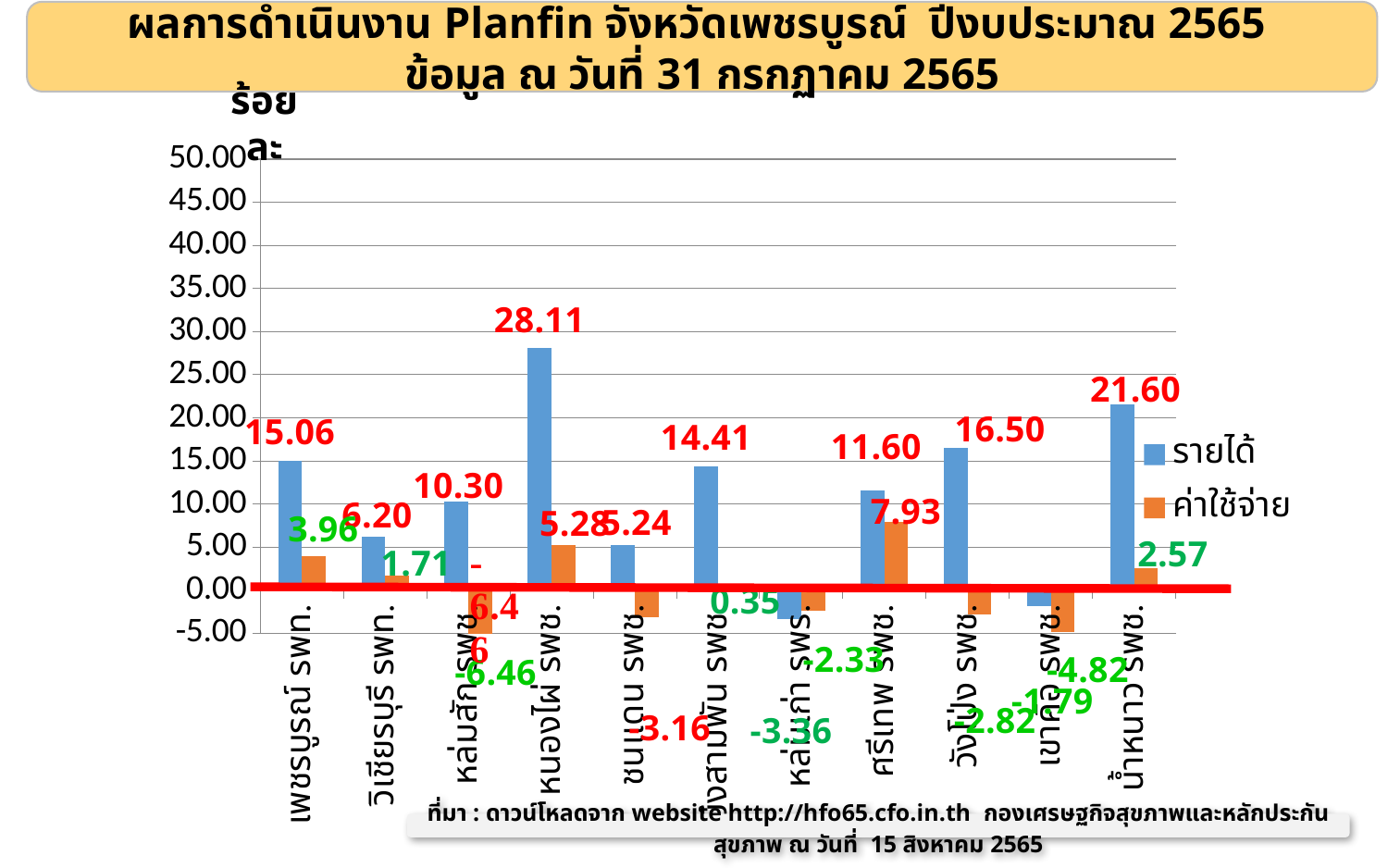
Which hospital has the highest ค่าใช้จ่าย value? ศรีเทพ รพช. What is the รายได้ value for น้ำหนาว รพช.? 21.60 What is the difference between the รายได้ and ค่าใช้จ่าย values for เพชรบูรณ์ รพท.? 11.10 What is the ค่าใช้จ่าย value for เพชรบูรณ์ รพท.? 3.96 Which has the larger รายได้ value, วังโป่ง รพช. or เพชรบูรณ์ รพท.? วังโป่ง รพช. What are the two series named in the legend? รายได้ and ค่าใช้จ่าย How many hospitals (categories) are shown on the x axis? 11 How many series does the legend list? 2 What is the ค่าใช้จ่าย value for ศรีเทพ รพช.? 7.93 What is the รายได้ value for หนองไผ่ รพช.? 28.11 Which hospital has the highest รายได้ value? หนองไผ่ รพช. What kind of chart is shown on the slide? bar chart